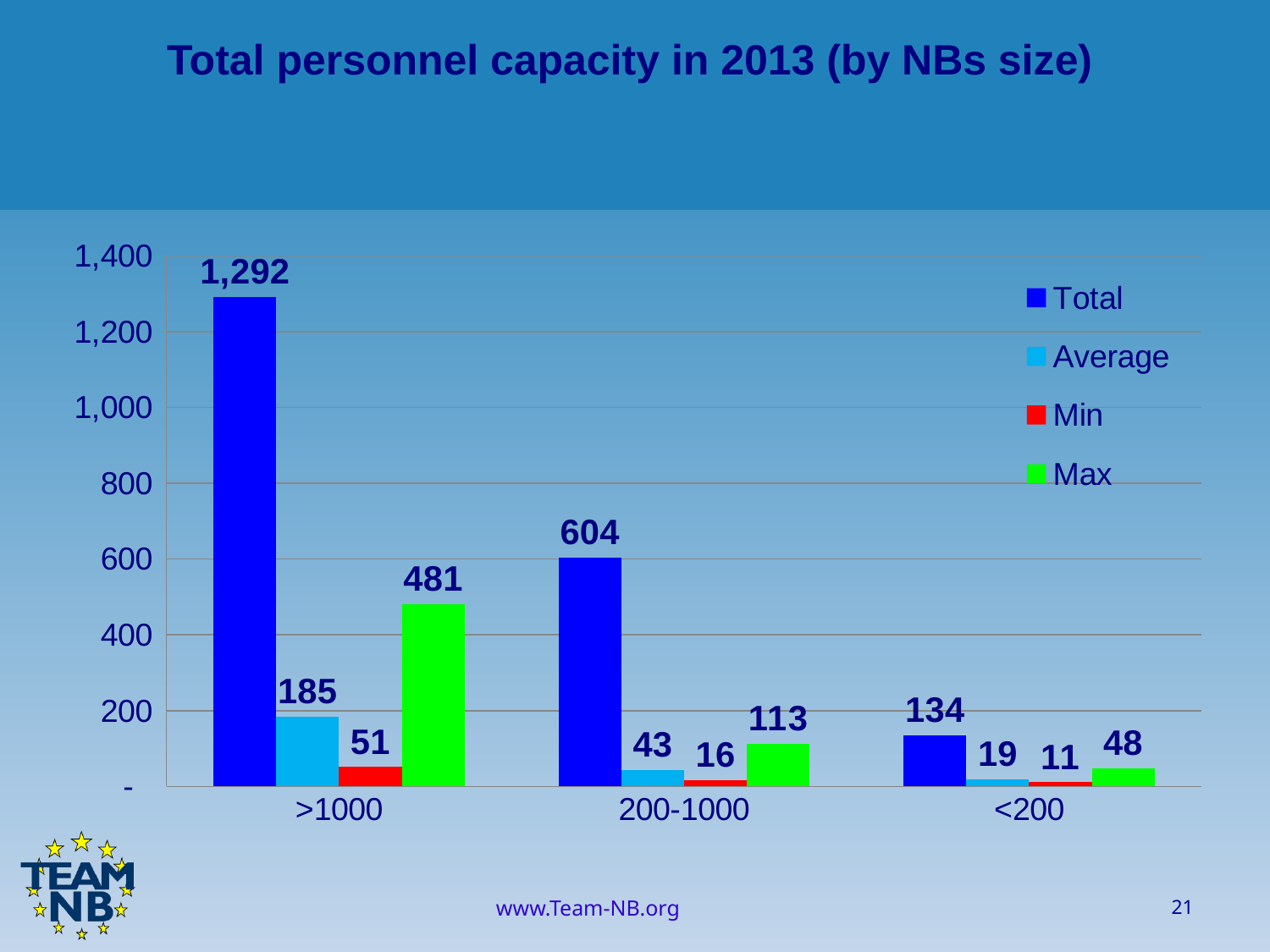
Is the Total value for <200 greater or less than 200? less Which is larger: the Max value for >1000 or the Total value for 200-1000? Total value for 200-1000 What kind of chart is shown on the slide? bar chart What is the Total value for the >1000 category? 1,292 What is the difference between the Total values for >1000 and 200-1000? 688 What is the Min value for the 200-1000 category? 16 What is the Average value for the <200 category? 19 Which category has the lowest Min value? <200 How many series does the legend list? 4 How many categories are shown on the x axis? 3 Which category has the highest Total value? >1000 What is the Max value for the 200-1000 category? 113